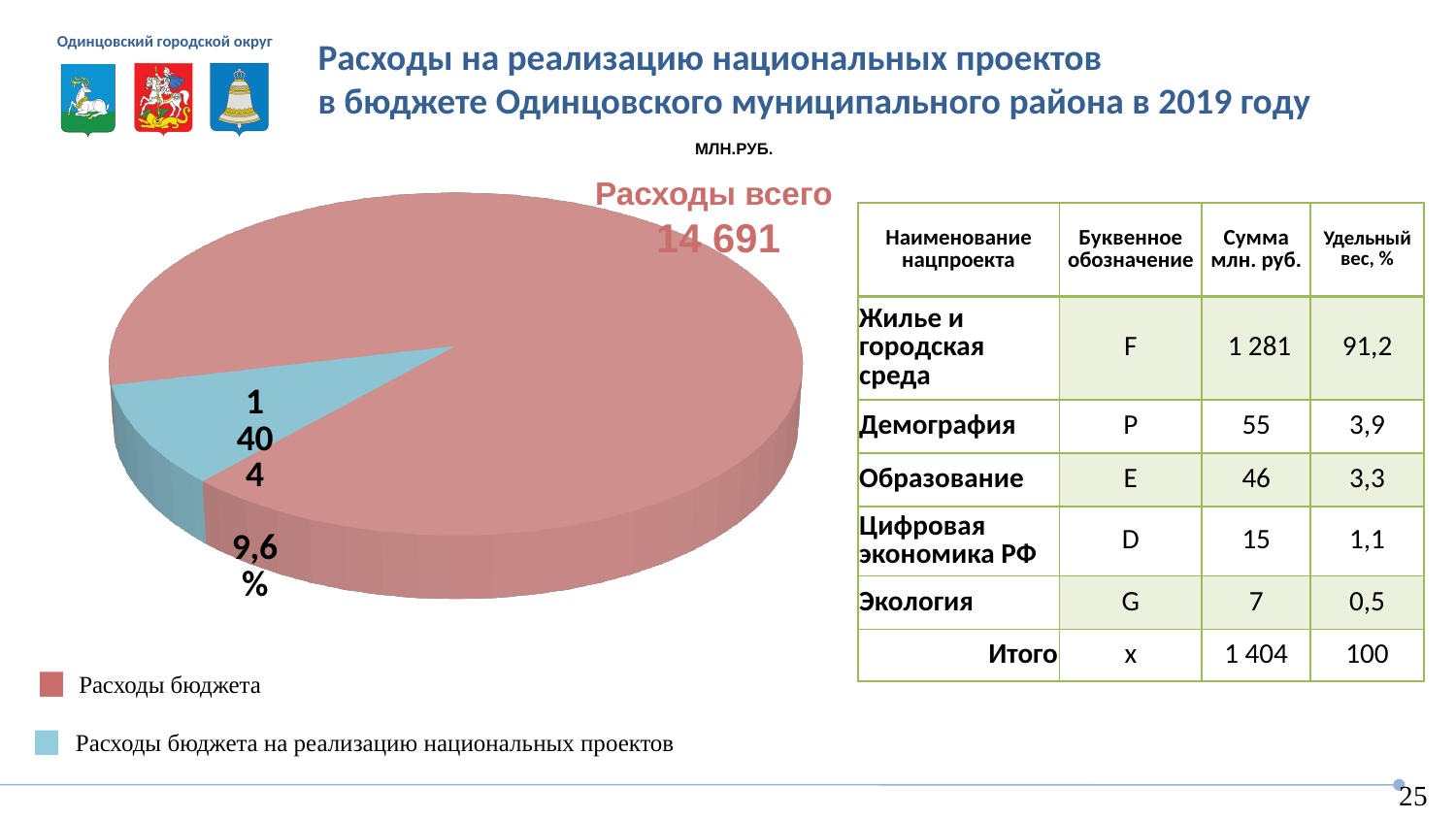
How many entries does the legend of the pie chart list? 2 Which slice of the pie chart is the largest? Расходы бюджета Which slice of the pie chart is the smallest? Расходы бюджета на реализацию национальных проектов How many slices does the pie chart have? 2 What colour is the slice for 'Расходы бюджета на реализацию национальных проектов' in the pie chart? Light blue What total is shown next to 'Расходы всего' on the pie chart? 14 691 What value is labelled on the slice for 'Расходы бюджета на реализацию национальных проектов'? 1 404 Which is larger in the pie chart: 'Расходы бюджета' or 'Расходы бюджета на реализацию национальных проектов'? Расходы бюджета In what unit are the values of the pie chart given, according to the label above it? млн.руб. Is the share of the slice 'Расходы бюджета на реализацию национальных проектов' greater or less than 50%? less What share of the pie does the slice 'Расходы бюджета на реализацию национальных проектов' represent? 9,6 % What kind of chart is shown on the slide? Pie chart